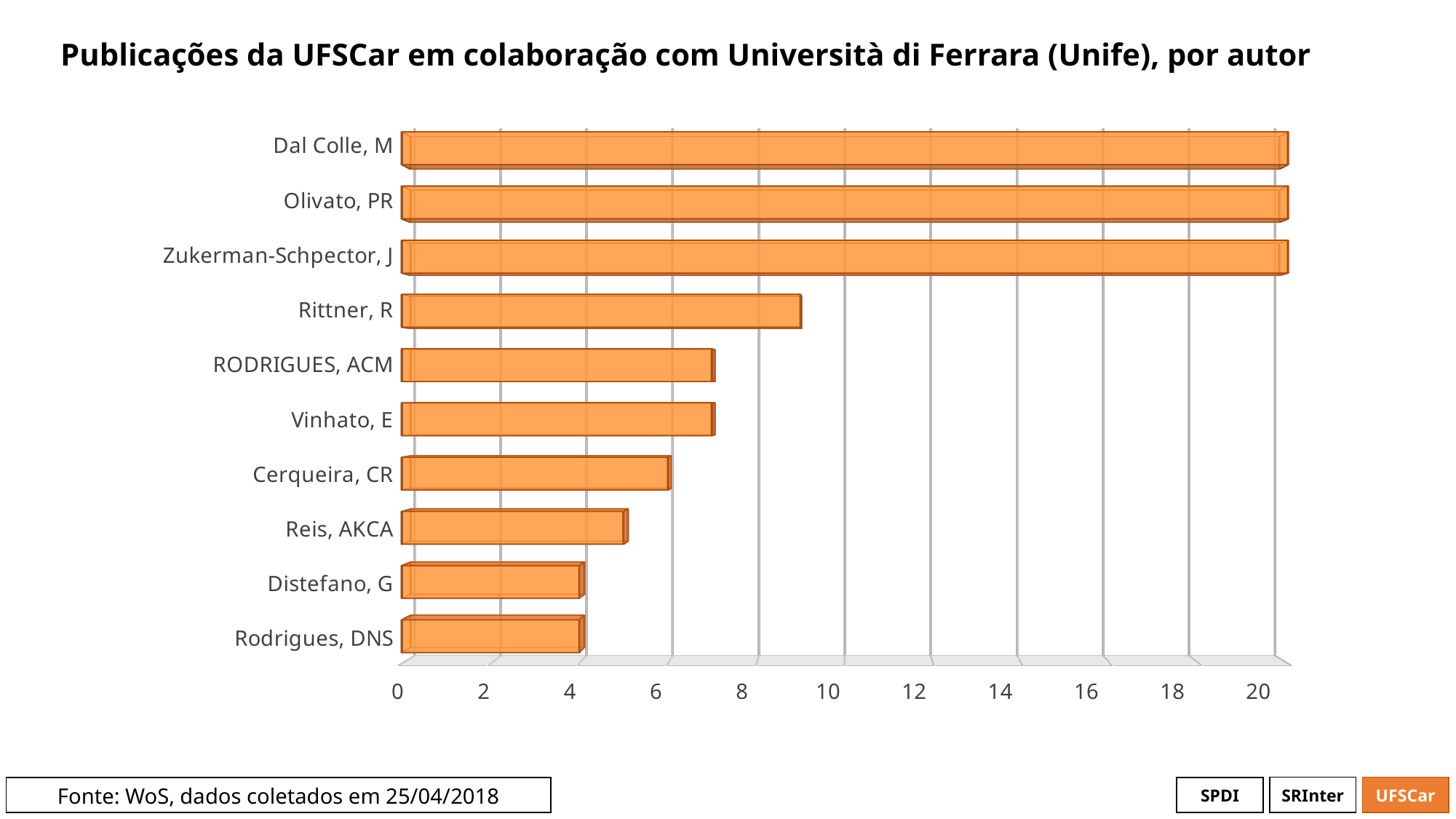
Is the value for RODRIGUES, ACM greater or less than 8? less Is the value for Reis, AKCA greater or less than 6? less How many authors are listed on the chart? 10 Is the value for Dal Colle, M greater or less than 18? greater Which has a larger value, Rittner, R or Cerqueira, CR? Rittner, R What kind of chart is shown on the slide? bar chart What is the title of the chart? Publicações da UFSCar em colaboração com Università di Ferrara (Unife), por autor Which has a larger value, Reis, AKCA or Distefano, G? Reis, AKCA Going from the top author to the bottom author, do the bar lengths rise or fall? fall